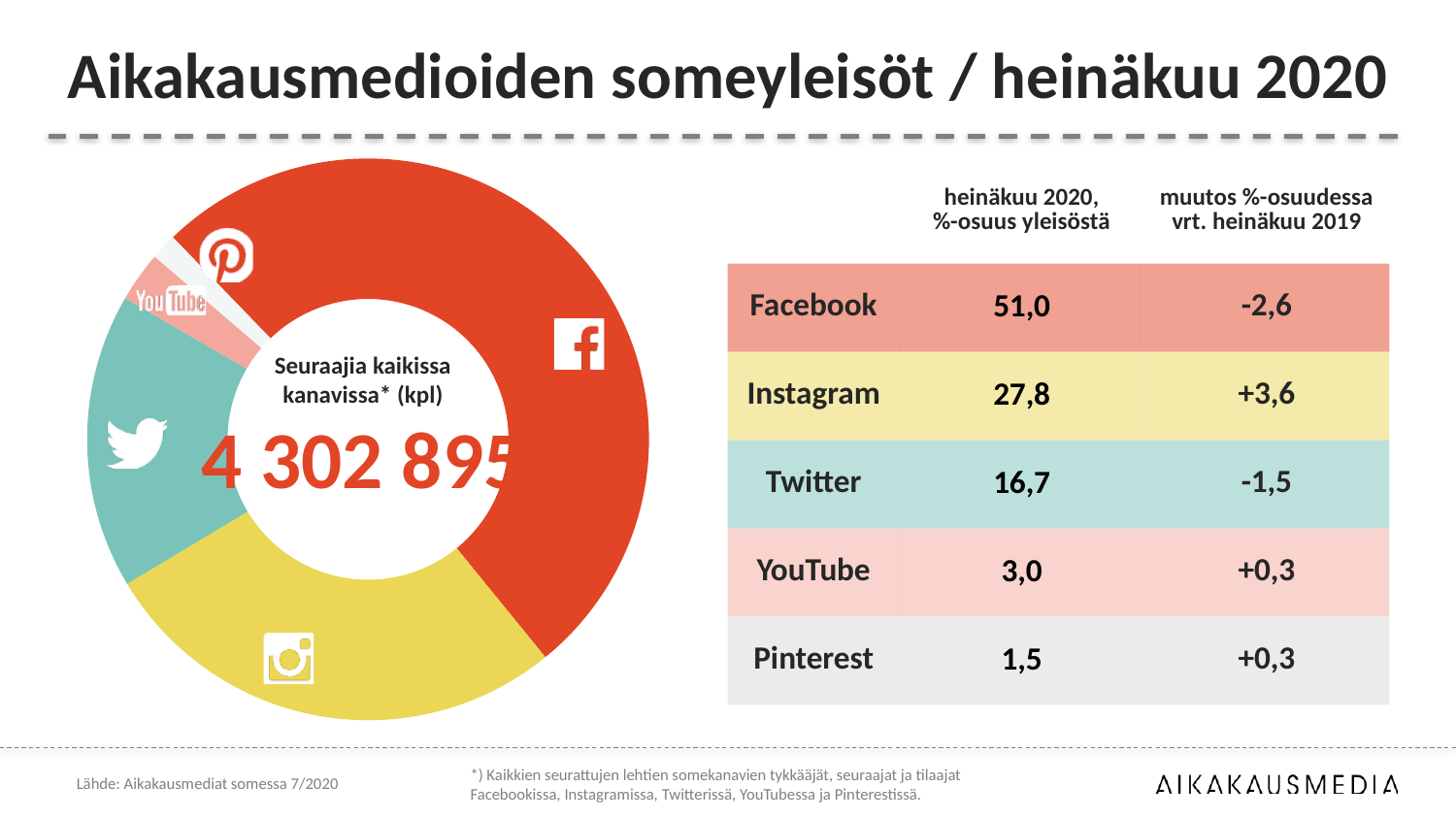
According to the table, what is Facebook's share of the audience in July 2020? 51,0 Which has a larger share of the audience, Twitter or YouTube? Twitter According to the table, what is Instagram's share of the audience in July 2020? 27,8 According to the table, what is Twitter's share of the audience in July 2020? 16,7 What total number of followers across all channels is shown in the centre of the donut chart? 4 302 895 What is the difference between Facebook's and Instagram's share of the audience in July 2020? 23,2 Which channel has the smallest share of the audience in the donut chart? Pinterest Which channel has the largest share of the audience in the donut chart? Facebook What is the change in percentage share for Instagram compared with July 2019? +3,6 How many channels (slices) are shown in the donut chart? 5 What is the change in percentage share for Facebook compared with July 2019? -2,6 What kind of chart is shown on the left of the slide? Donut (pie) chart